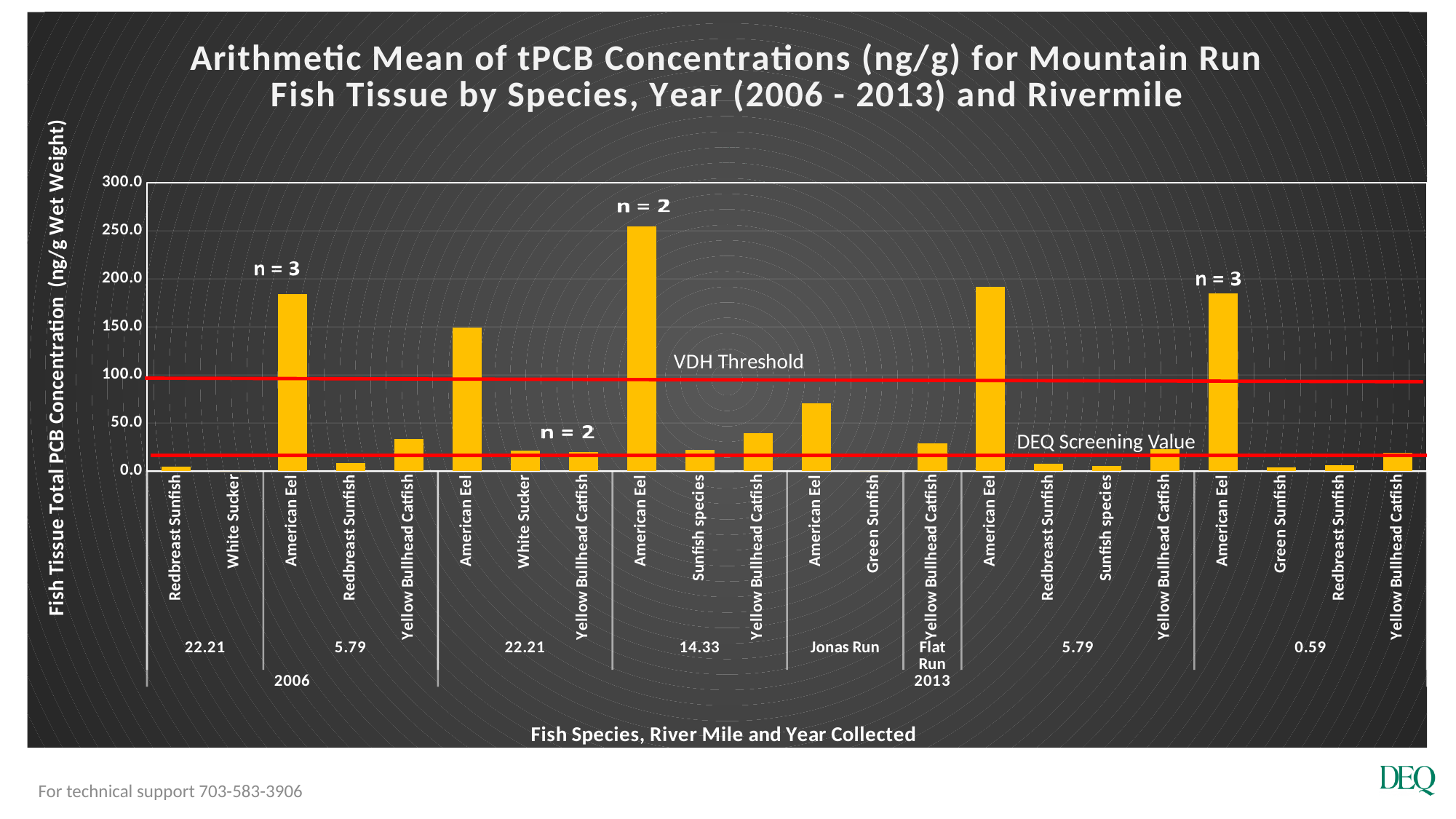
What do the two red horizontal lines on the chart represent? VDH Threshold and DEQ Screening Value What is the label of the y-axis? Fish Tissue Total PCB Concentration (ng/g Wet Weight) What kind of chart is shown on the slide? Bar chart How many bars (fish species entries) are plotted on the chart? 22 Is the value for American Eel at river mile 5.79 in 2013 greater or less than 150.0? greater Is the value for American Eel at Jonas Run greater or less than 100.0? less Is the value for Yellow Bullhead Catfish at river mile 5.79 in 2006 greater or less than 50.0? less Which is larger: the value for American Eel at Jonas Run or the value for Yellow Bullhead Catfish at Flat Run? American Eel at Jonas Run Which bar has the highest tPCB concentration on the chart? American Eel at river mile 14.33 (2013)